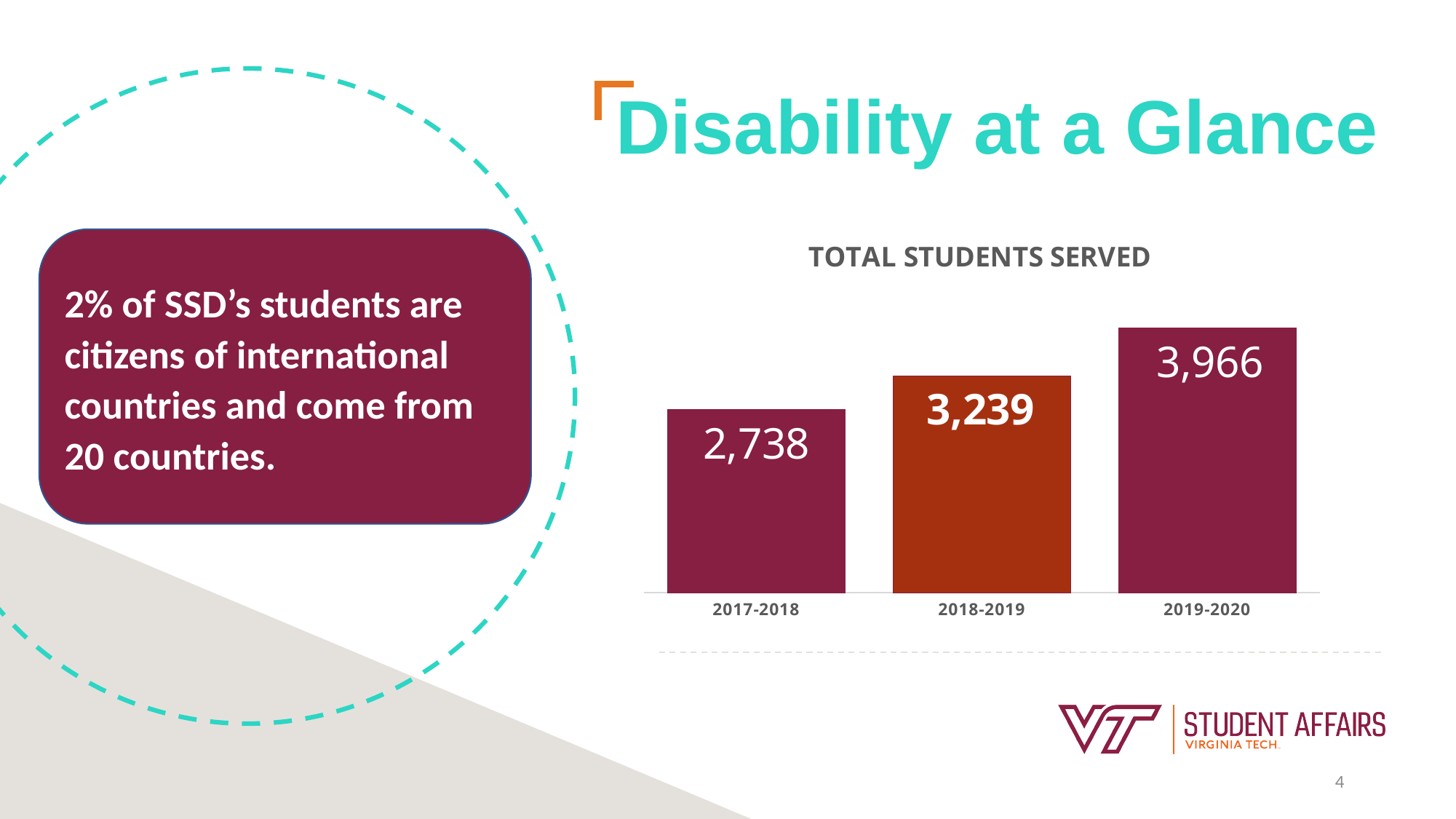
Which year has the lowest number of total students served? 2017-2018 Do the values in the Total Students Served chart rise or fall from 2017-2018 to 2019-2020? Rise Which year has the highest number of total students served? 2019-2020 What is the difference between the values for 2018-2019 and 2017-2018? 501 What kind of chart is used to show Total Students Served? Bar chart What is the value for 2017-2018 in the Total Students Served chart? 2,738 What is the difference between the values for 2019-2020 and 2017-2018? 1,228 How many categories are shown in the Total Students Served chart? 3 What is the title of the chart on the slide? TOTAL STUDENTS SERVED What is the value for 2018-2019 in the Total Students Served chart? 3,239 Which is larger, the value for 2018-2019 or the value for 2019-2020? 2019-2020 What is the value for 2019-2020 in the Total Students Served chart? 3,966